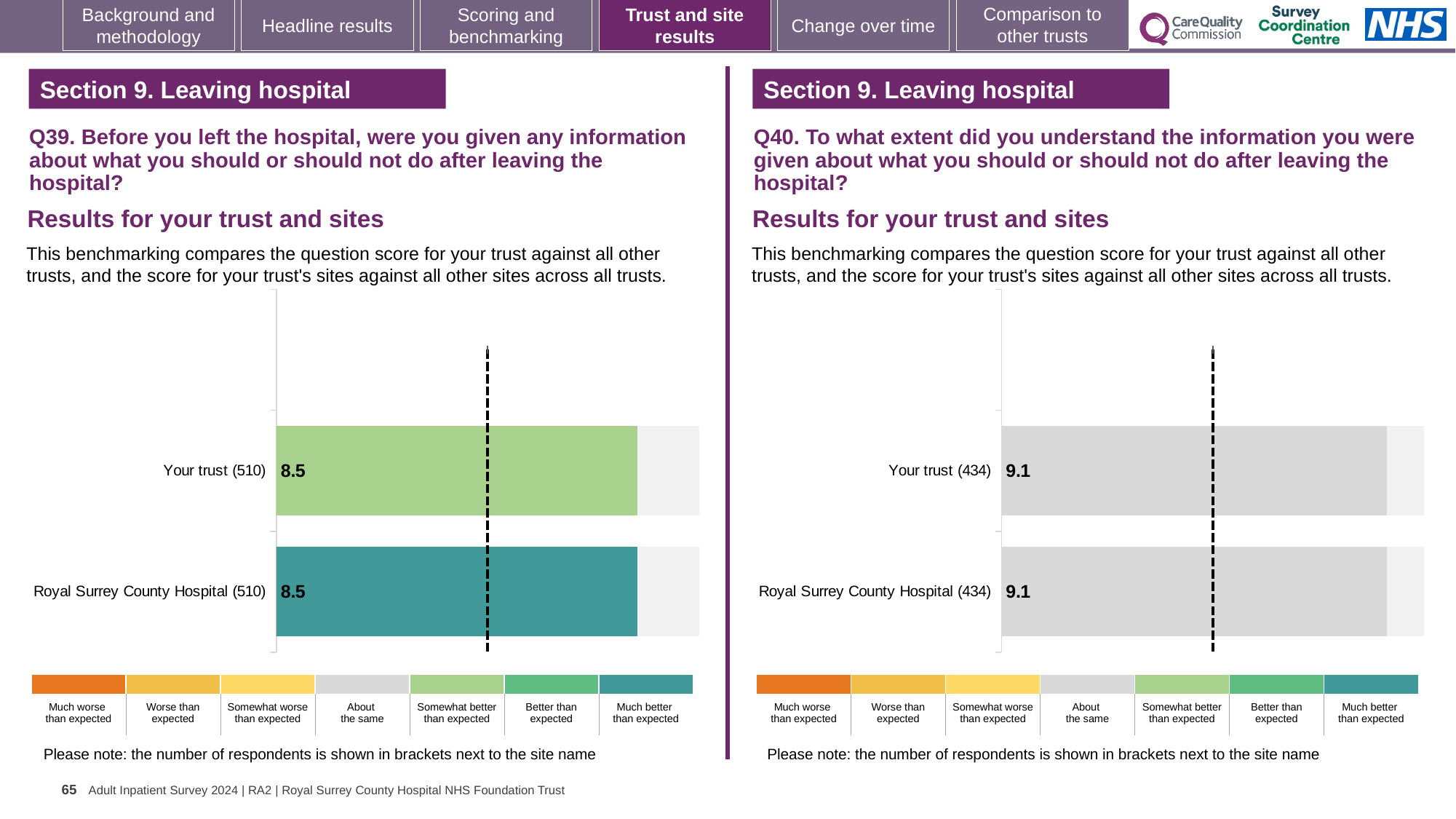
How many bars are plotted on the Q39 chart (left)? 2 On the Q39 chart (left), how many respondents are shown in brackets next to Your trust? 510 How many bars are plotted on the Q40 chart (right)? 2 On the Q39 chart (left), which benchmark category does the colour of the Royal Surrey County Hospital bar correspond to in the key? Much better than expected On the Q40 chart (right), what is the score for Royal Surrey County Hospital? 9.1 On the Q40 chart (right), how many respondents are shown in brackets next to Royal Surrey County Hospital? 434 On the Q39 chart (left), what is the difference between the score for Your trust and the score for Royal Surrey County Hospital? 0 On the Q40 chart (right), what is the score for Your trust? 9.1 On the Q39 chart (left), what is the score for Royal Surrey County Hospital? 8.5 What kind of chart is used on the Q39 chart (left)? Bar chart On the Q39 chart (left), what is the score for Your trust? 8.5 On the Q40 chart (right), what is the difference between the score for Your trust and the score for Royal Surrey County Hospital? 0